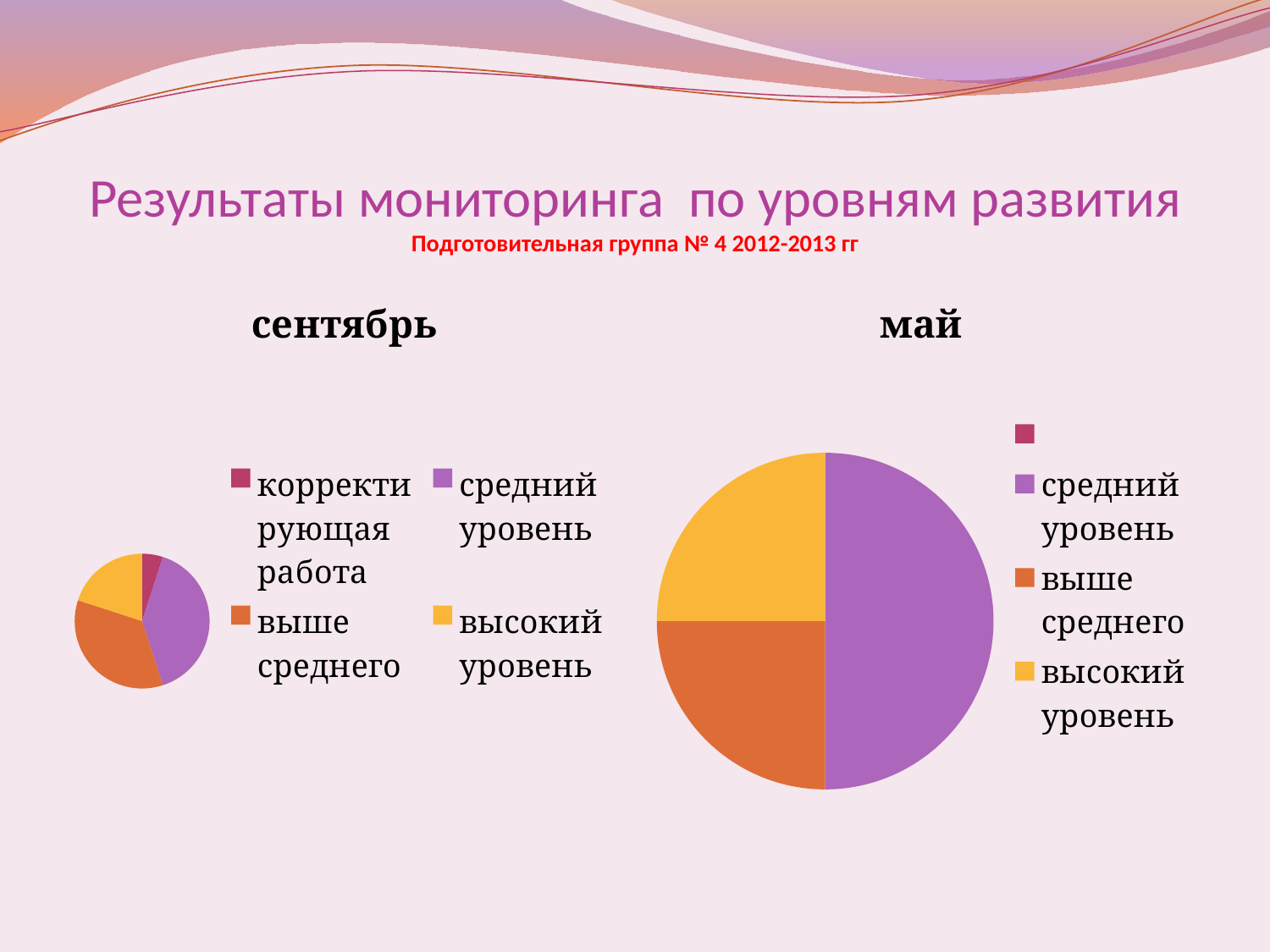
What kind of chart is the "май" chart on the right? pie chart In the "май" chart, what colour represents "высокий уровень"? yellow In the "сентябрь" chart, which category has the largest slice? средний уровень In the "май" chart, which slice is larger: "средний уровень" or "высокий уровень"? средний уровень In the "сентябрь" chart, which slice is larger: "средний уровень" or "высокий уровень"? средний уровень What kind of chart is the "сентябрь" chart on the left? pie chart In the "сентябрь" chart, which category has the smallest slice? корректирующая работа In the "сентябрь" chart, what colour represents "средний уровень"? purple In the "май" chart, which category has the largest slice? средний уровень In the "сентябрь" chart, which slice is larger: "выше среднего" or "корректирующая работа"? выше среднего How many slices are visible in the "май" pie chart? 3 How many categories does the legend of the "сентябрь" chart list? 4